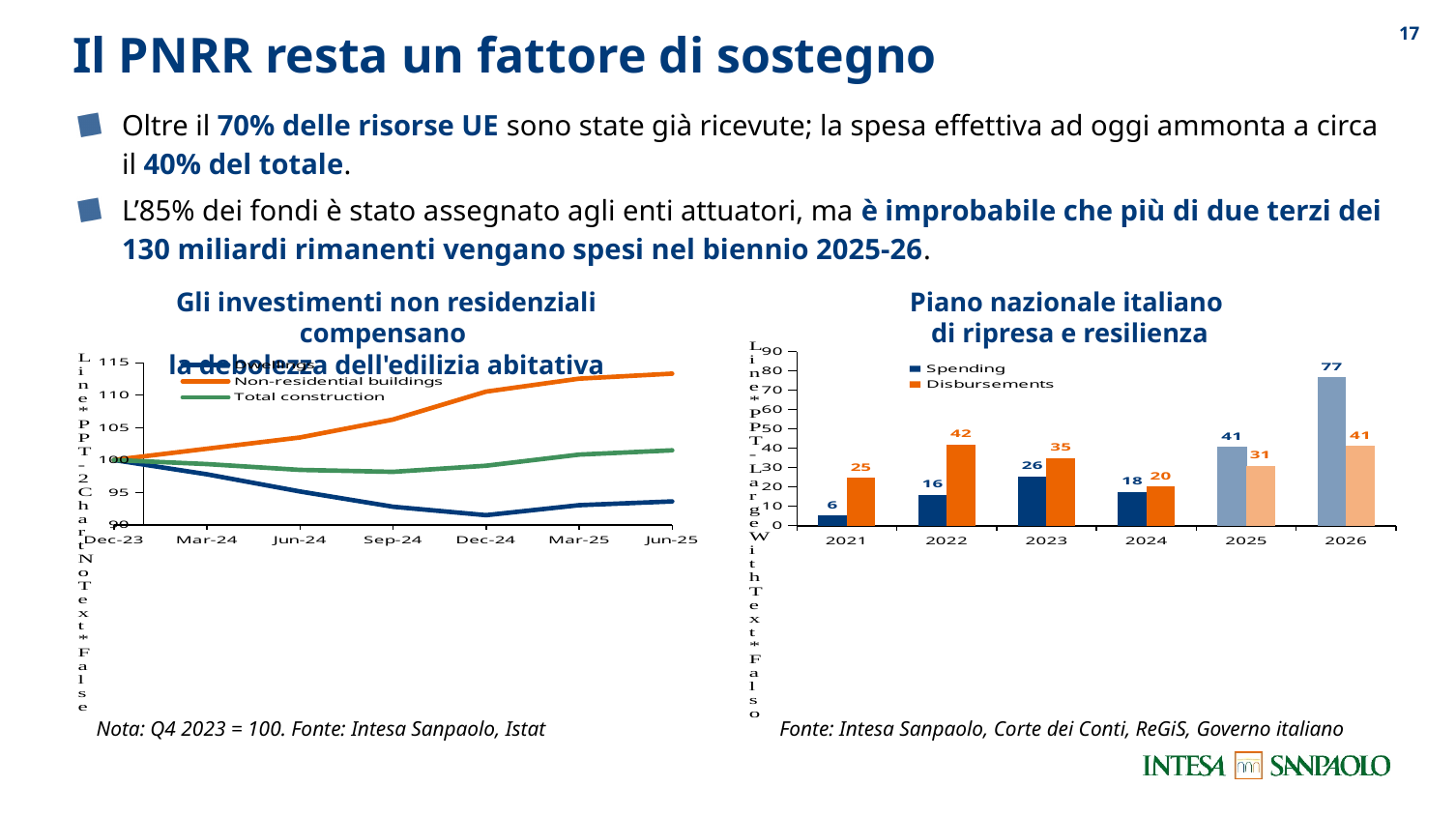
In the left chart 'Gli investimenti non residenziali compensano la debolezza dell'edilizia abitativa', does the Non-residential buildings line rise or fall from Dec-23 to Jun-25? Rise In the 'Piano nazionale italiano di ripresa e resilienza' chart, which year has the highest Spending value? 2026 In the 'Piano nazionale italiano di ripresa e resilienza' chart, what is the Disbursements value for 2022? 42 In the 'Piano nazionale italiano di ripresa e resilienza' chart, which is larger in 2025, Spending or Disbursements? Spending In the 'Piano nazionale italiano di ripresa e resilienza' chart, what is the Spending value for 2026? 77 In the 'Piano nazionale italiano di ripresa e resilienza' chart, how many series does the legend list? 2 In the left chart 'Gli investimenti non residenziali compensano la debolezza dell'edilizia abitativa', how many series does the legend list? 3 In the 'Piano nazionale italiano di ripresa e resilienza' chart, what is the difference between Disbursements and Spending in 2021? 19 In the 'Piano nazionale italiano di ripresa e resilienza' chart, how many years are shown on the x axis? 6 What kind of chart is the 'Piano nazionale italiano di ripresa e resilienza' chart? Bar chart In the 'Piano nazionale italiano di ripresa e resilienza' chart, which year has the lowest Spending value? 2021 In the left chart 'Gli investimenti non residenziali compensano la debolezza dell'edilizia abitativa', is the value for Non-residential buildings at Jun-25 greater or less than 110? greater